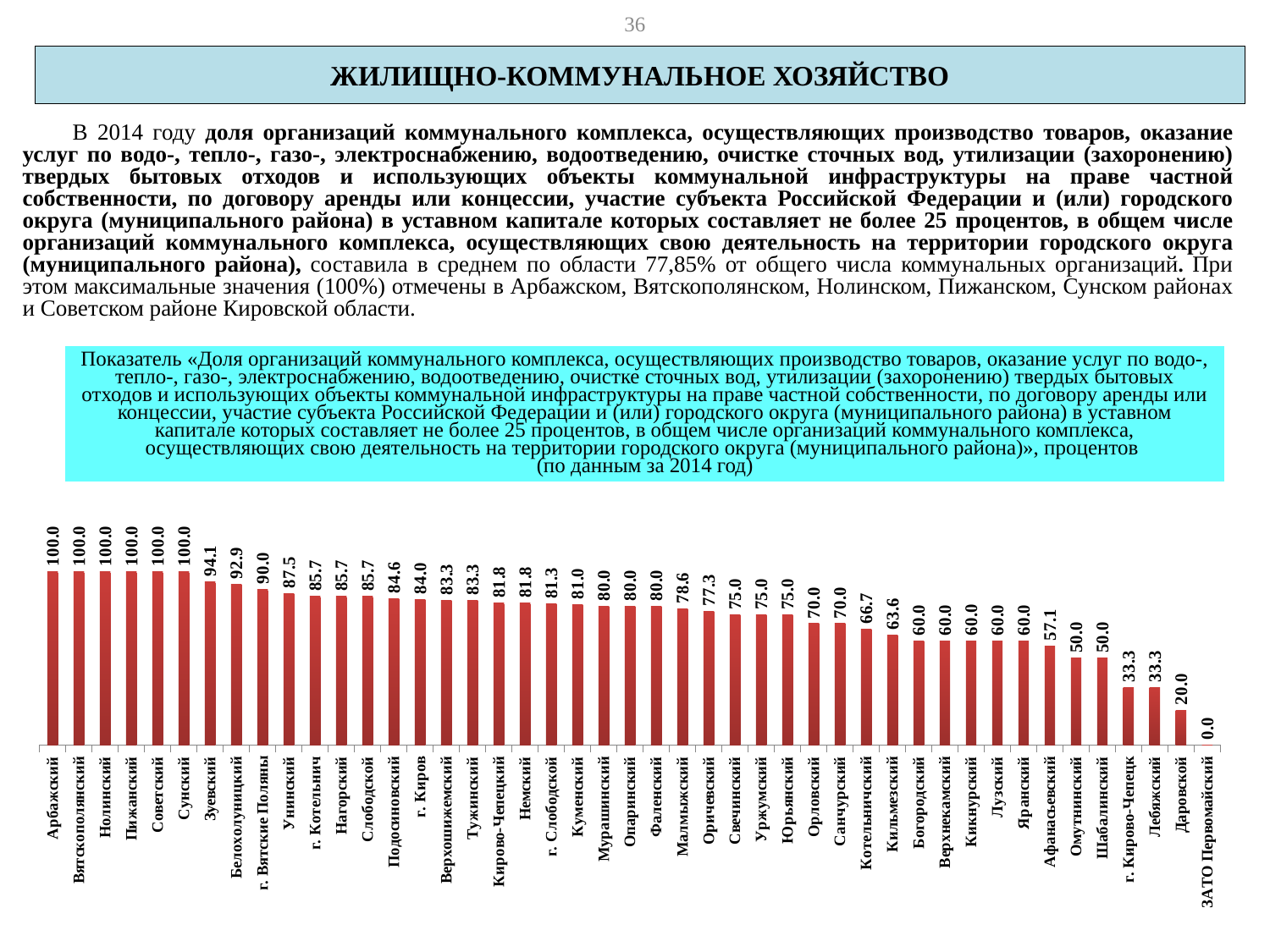
What is the value for Кильмезский? 63.6 Which is larger, the value for Малмыжский or the value for Оричевский? Малмыжский Which category has the lowest value? ЗАТО Первомайский What is the difference between the values for Белохолуницкий and Афанасьевский? 35.8 What is the value for Даровской? 20.0 What is the value for Зуевский? 94.1 How many categories are shown on the x axis? 45 What is the value for Котельничский? 66.7 What is the value for г. Киров? 84.0 Do the values rise or fall from left to right along the x axis? fall Which is larger, the value for Лебяжский or the value for Омутнинский? Омутнинский What kind of chart is shown on the slide? bar chart